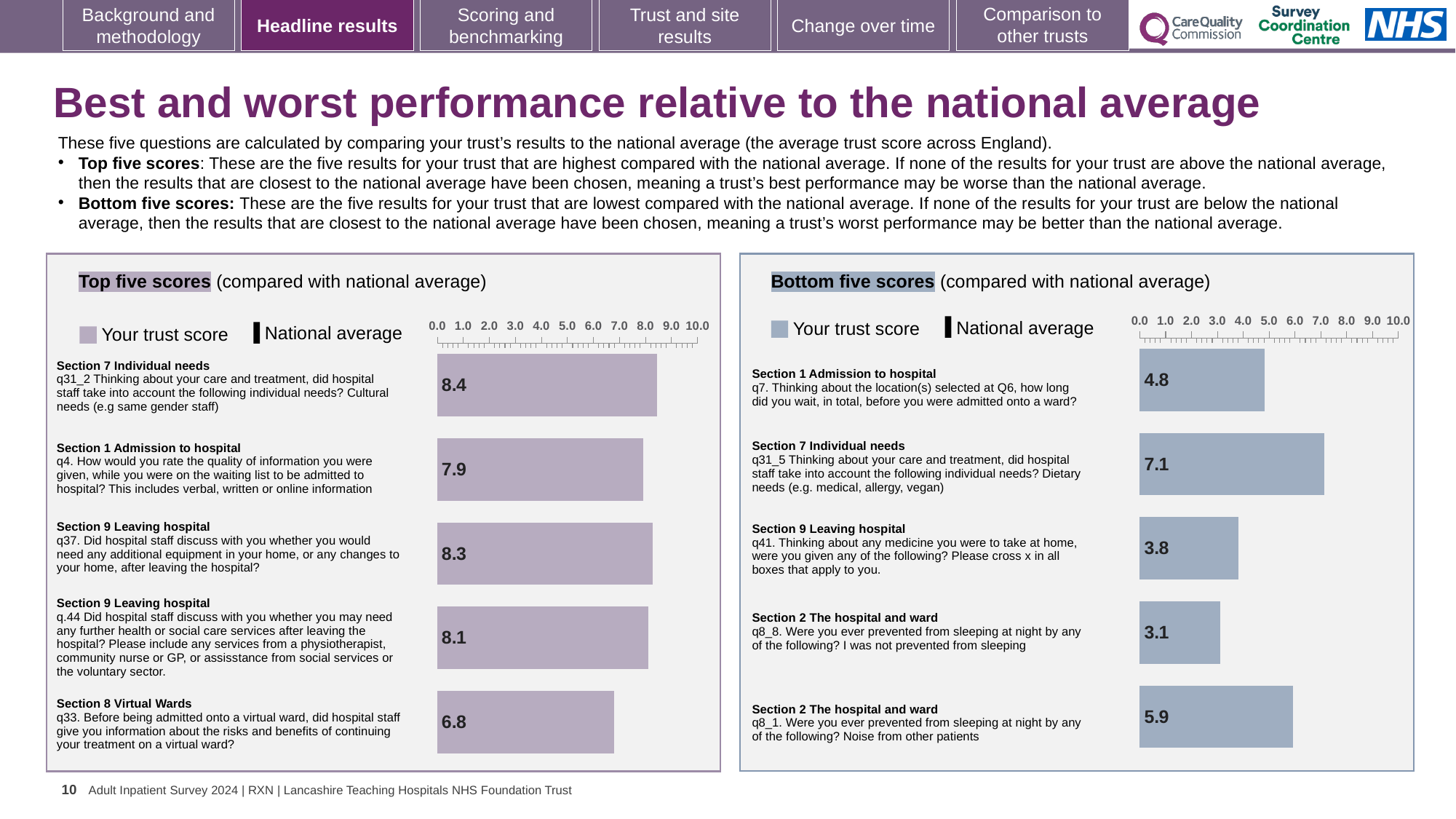
In the 'Bottom five scores' chart, what is the difference between the trust scores for q8_1 and q41? 2.1 In the 'Bottom five scores' chart, which question has the lowest trust score? q8_8 (Section 2 The hospital and ward) What type of chart is used in the 'Top five scores' panel? Bar chart In the 'Top five scores' chart, what is the difference between the trust scores for q31_2 and q4? 0.5 In the 'Bottom five scores' chart, what is the trust score for q31_5 (Dietary needs)? 7.1 In the 'Bottom five scores' chart, what is the trust score for q8_8 (I was not prevented from sleeping)? 3.1 In the 'Top five scores' chart, what is the trust score for q33 (Section 8 Virtual Wards)? 6.8 In the 'Bottom five scores' chart, is the trust score for q7 larger or smaller than the trust score for q8_1? smaller In the 'Top five scores' chart, what is the trust score for q31_2 (Cultural needs)? 8.4 In the 'Bottom five scores' chart, which question has the highest trust score? q31_5 (Section 7 Individual needs, Dietary needs) In the 'Top five scores' chart, how many questions are plotted? 5 In the 'Top five scores' chart, which question has the lowest trust score? q33 (Section 8 Virtual Wards)